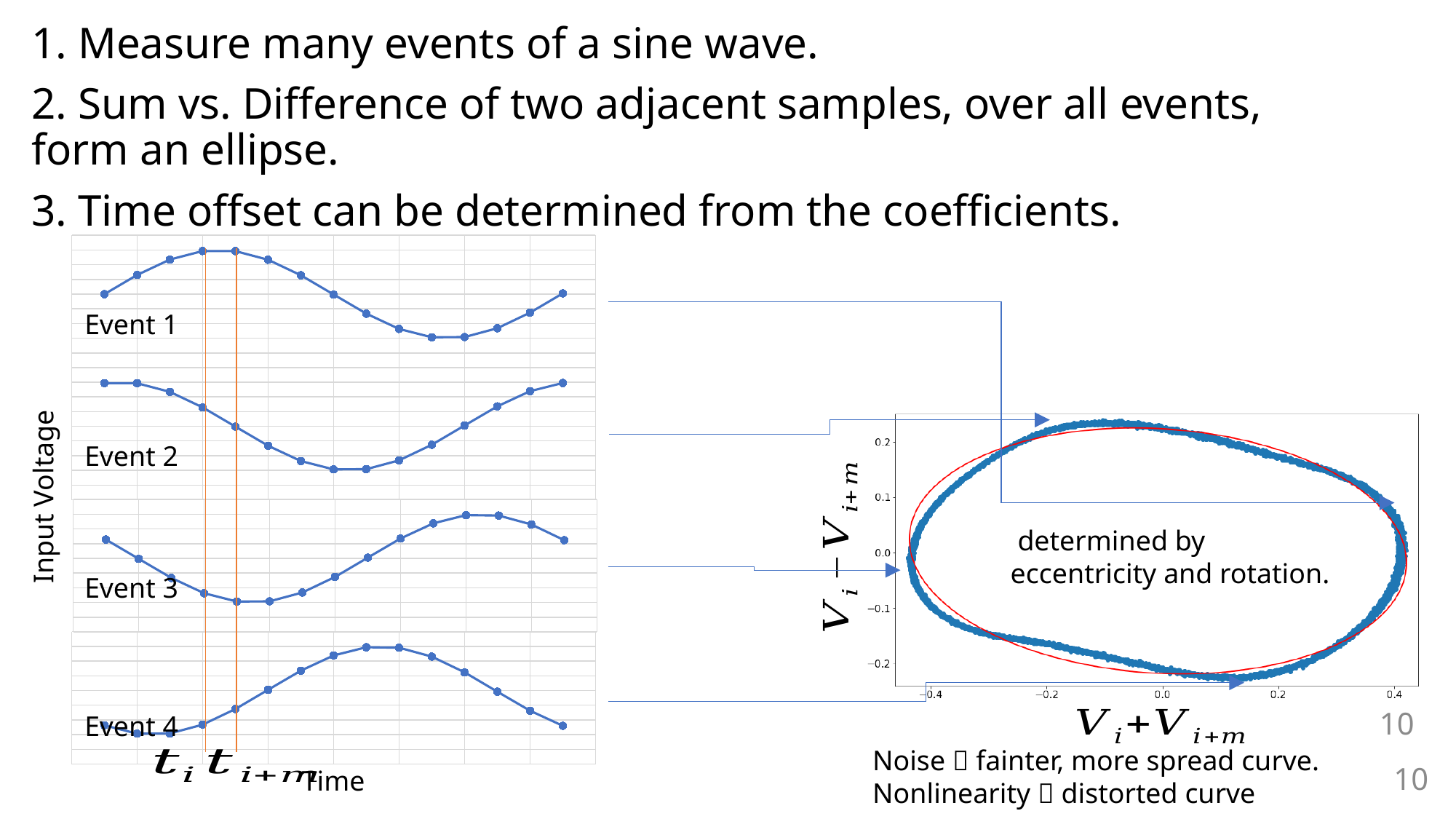
On the right chart, is the largest x-axis tick value greater or less than 0.2? greater On the left chart, how many events are plotted? 4 On the right chart, is the highest y-axis tick value greater or less than 0.1? greater On the right chart, what is the x-axis label? V_i + V_{i+m} On the left chart, does the Event 1 curve rise or fall between t_i and the point where it reaches its lowest value? fall On the left chart, does the Event 4 curve rise or fall immediately after t_{i+m}? rise On the left chart, which event reaches its maximum value at the time marked t_i? Event 1 On the left chart, what is the y-axis label? Input Voltage What kind of chart is the left chart showing Event 1 to Event 4? line chart What kind of chart is the right chart with the ellipse? scatter plot